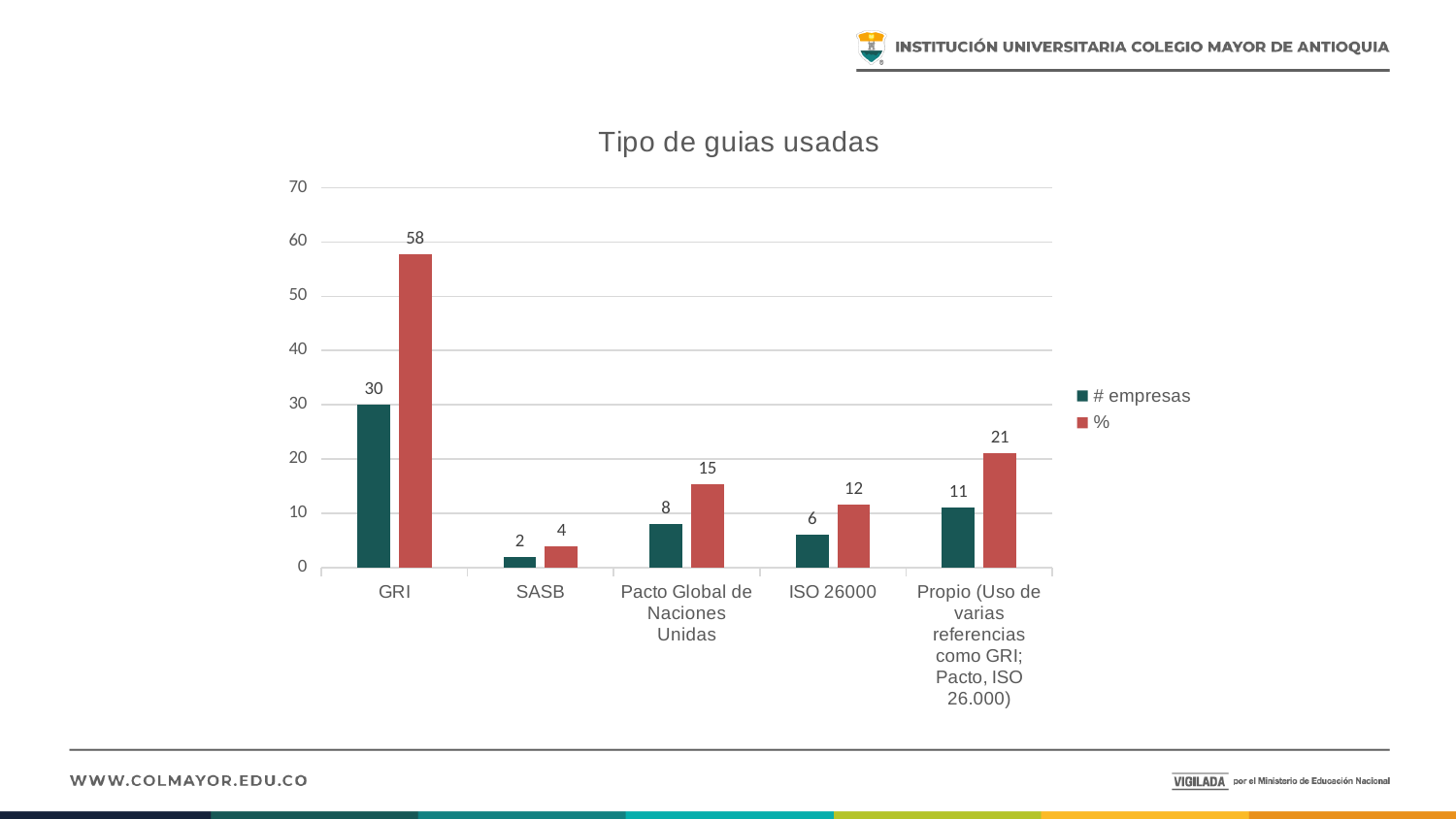
Which category has the lowest "# empresas" value? SASB What is the "# empresas" value for ISO 26000? 6 What is the "%" value for Propio (Uso de varias referencias como GRI; Pacto, ISO 26.000)? 21 What is the "%" value for Pacto Global de Naciones Unidas? 15 What is the difference between the "%" values for GRI and SASB? 54 How many series does the legend list? 2 How many categories are shown on the x axis? 5 What kind of chart is shown on the slide? Bar chart What is the title of the chart? Tipo de guias usadas Which is larger: the "# empresas" value for ISO 26000 or for Propio (Uso de varias referencias como GRI; Pacto, ISO 26.000)? Propio (Uso de varias referencias como GRI; Pacto, ISO 26.000) Which category has the highest "%" value? GRI What is the value of "# empresas" for GRI? 30